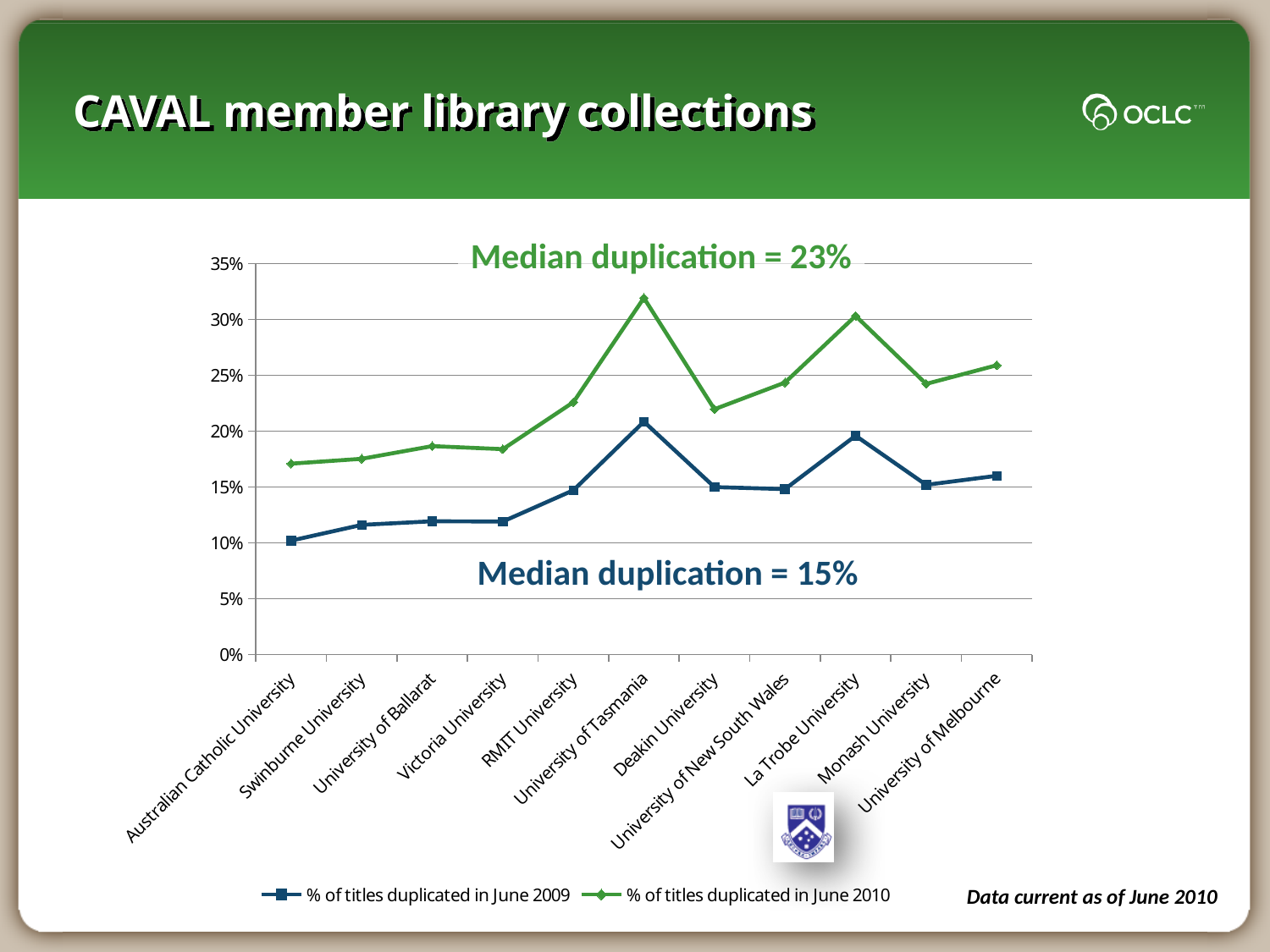
How many universities are plotted along the x axis? 11 What median duplication value is annotated for the June 2010 series? 23% Is the % of titles duplicated in June 2010 for Deakin University greater or less than 25%? less What kind of chart is shown on the slide? Line chart Which university has the highest % of titles duplicated in June 2010? University of Tasmania Is the % of titles duplicated in June 2009 for Australian Catholic University greater or less than 15%? less How many series does the legend list? 2 Which university has the lowest % of titles duplicated in June 2009? Australian Catholic University Is the % of titles duplicated in June 2010 for RMIT University greater or less than 20%? greater Which is larger: the % of titles duplicated in June 2010 for La Trobe University or for Deakin University? La Trobe University What median duplication value is annotated for the June 2009 series? 15%